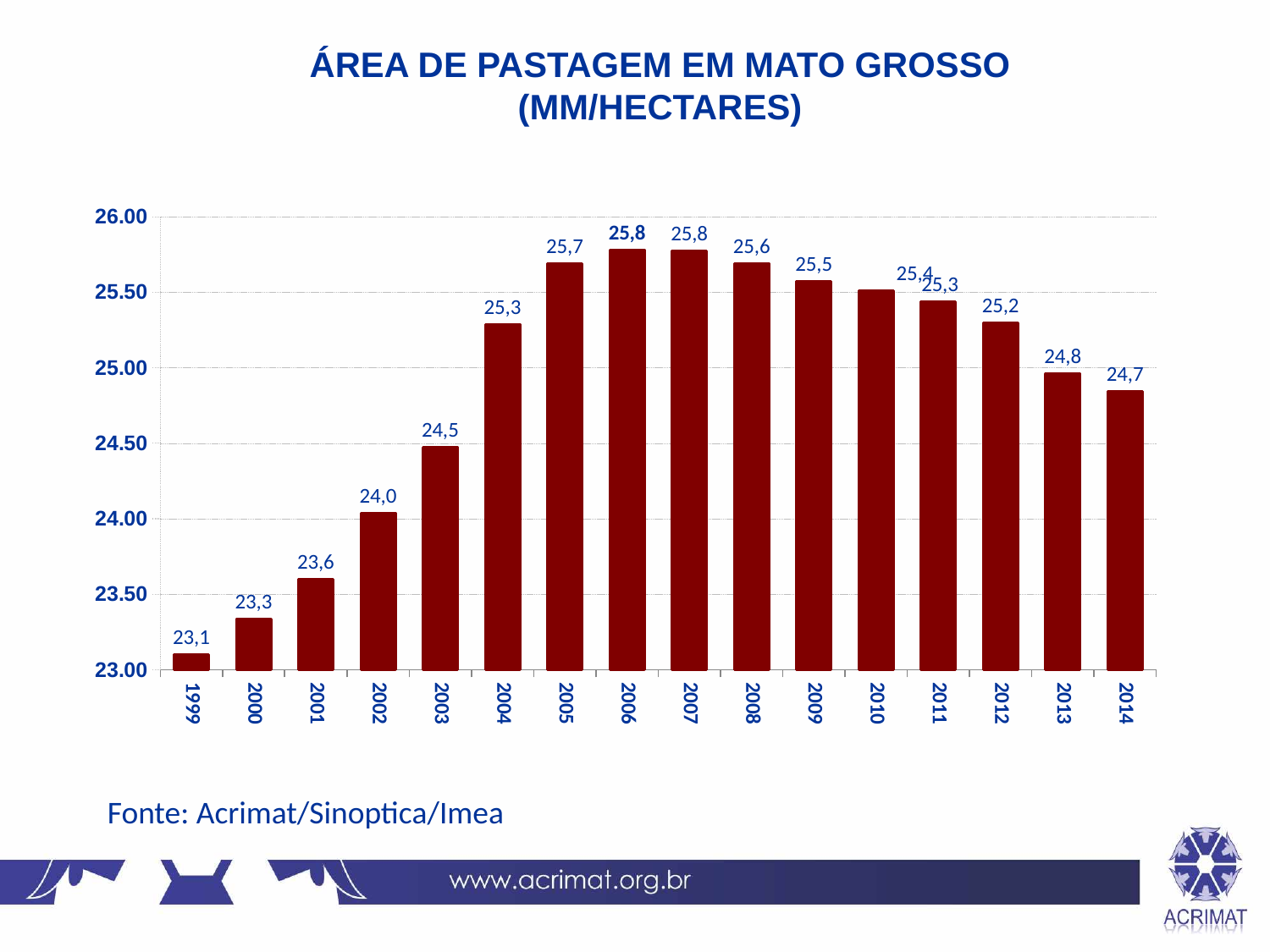
Which year has the lowest pasture area? 1999 How many years are shown on the x axis? 16 What is the value shown for 2014? 24,7 What is the difference between the values for 2014 and 1999? 1,6 What kind of chart is shown on the slide? bar chart Which year has the larger value, 2003 or 2013? 2013 Do the values rise or fall from 2007 to 2014? fall Is the value for 2005 greater or less than 25.50? greater What is the pasture area value shown for 1999? 23,1 What is the value shown for 2004? 25,3 What is the title of the chart? ÁREA DE PASTAGEM EM MATO GROSSO (MM/HECTARES) Is the value for 2001 greater or less than 24.00? less